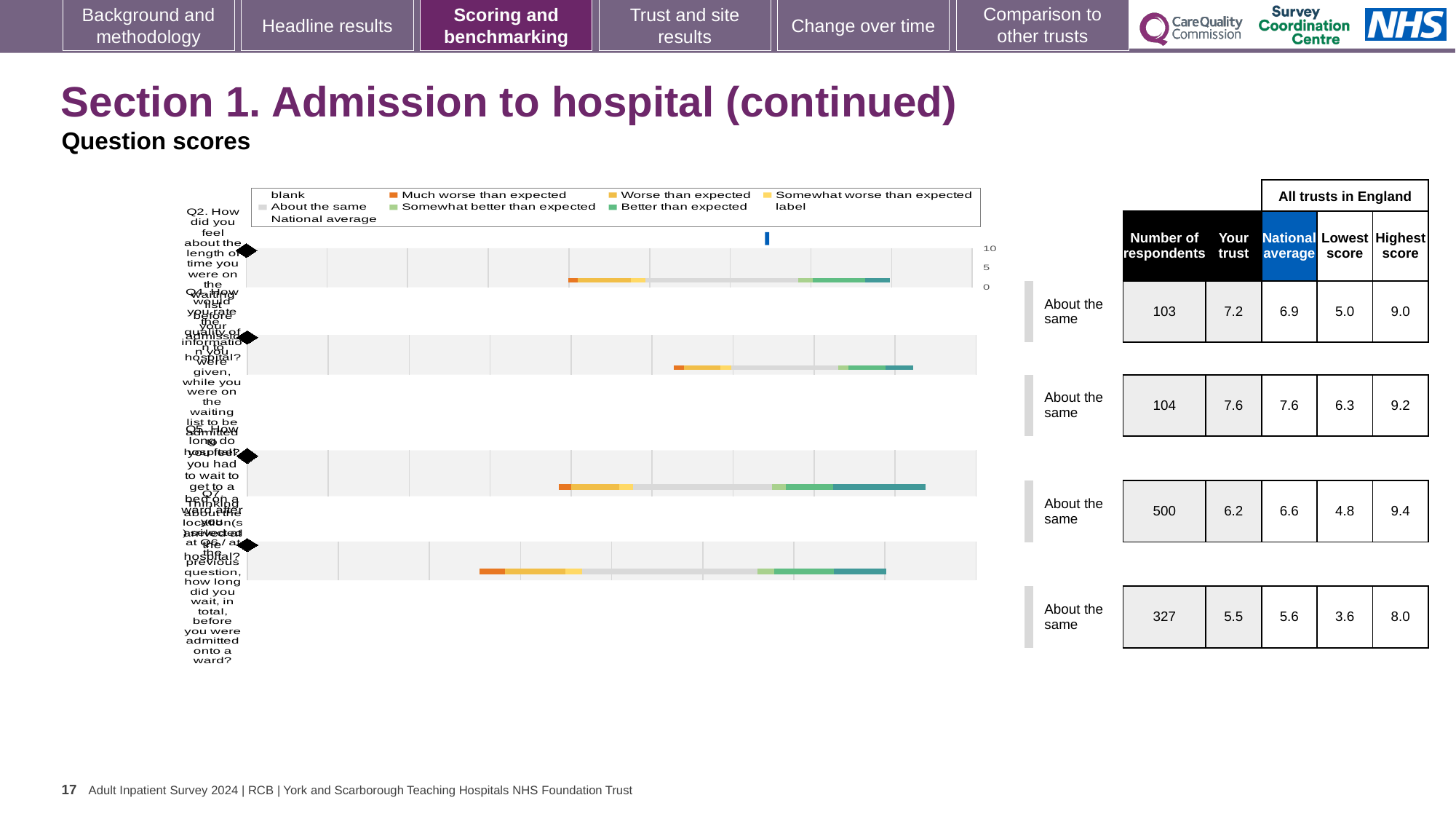
What is the number of respondents for the first (top) question row, Q2? 103 What is the national average for the fourth (bottom) question row? 5.6 What kind of chart is shown on the slide? bar chart How many entries does the chart legend list? 9 What is the 'Your trust' score for the third question row? 6.2 For the first question row, what is the difference between the highest score and the lowest score? 4.0 For the third question row, which is larger: the 'Your trust' score or the national average? national average Which question row has the lowest 'Your trust' score? the fourth row (5.5) What benchmark category is shown for every question row on the slide? About the same Which question row has the largest number of respondents? the third row (500) What is the highest score among all trusts in England for the third question row? 9.4 How many question rows (bars) does the chart show? 4